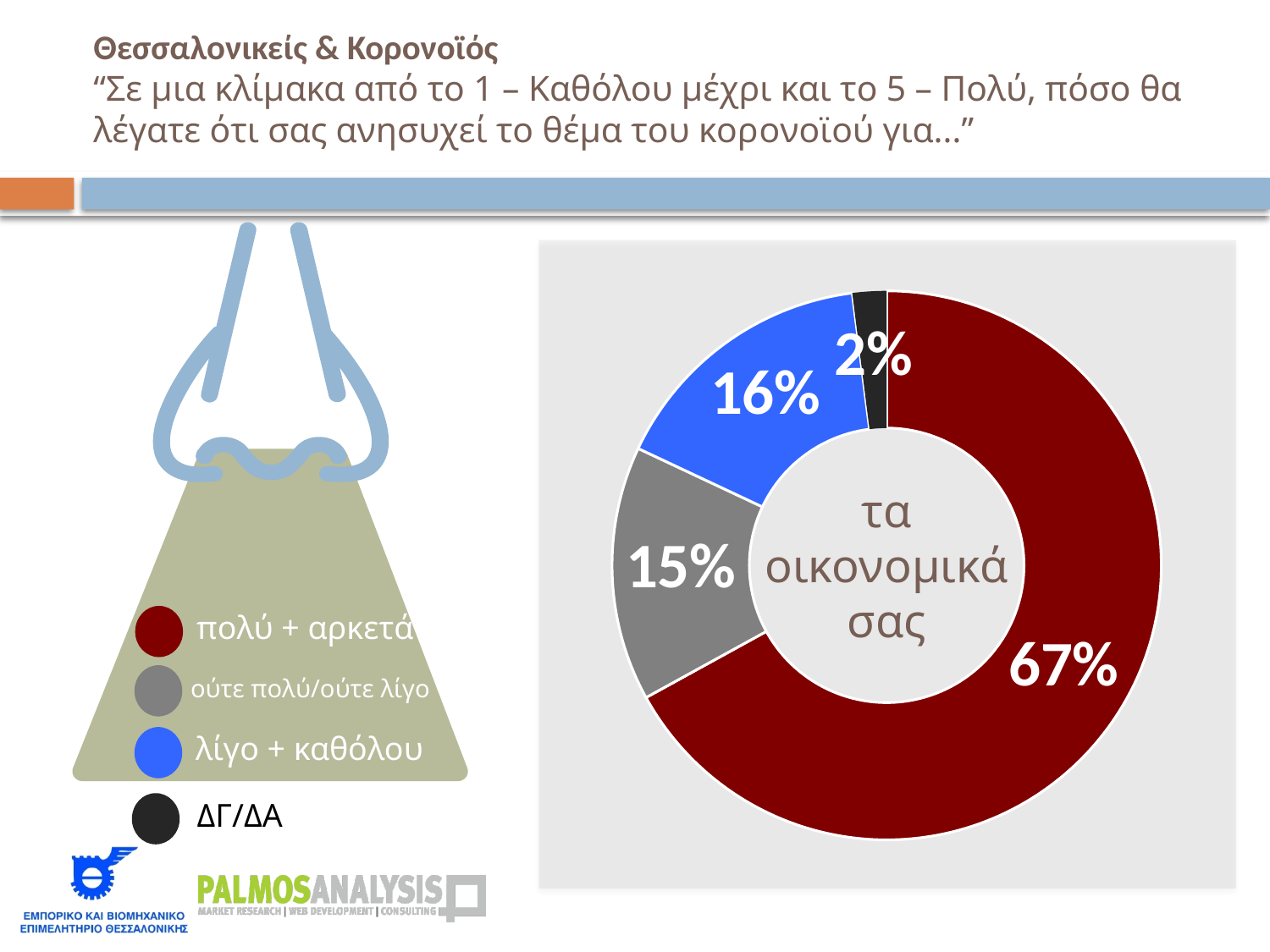
Which response category has the smallest share of the doughnut chart? ΔΓ/ΔΑ What percentage of respondents answered "πολύ + αρκετά" regarding concern about "τα οικονομικά σας"? 67% What percentage of respondents answered "λίγο + καθόλου"? 16% What topic is written in the centre of the doughnut chart? τα οικονομικά σας Which response category has the largest share of the doughnut chart? πολύ + αρκετά How many response categories are shown in the doughnut chart? 4 Which is larger: the share for "λίγο + καθόλου" or the share for "ούτε πολύ/ούτε λίγο"? λίγο + καθόλου What percentage of respondents answered "ούτε πολύ/ούτε λίγο"? 15% What is the difference in percentage points between "πολύ + αρκετά" and "λίγο + καθόλου"? 51 What percentage of respondents answered "ΔΓ/ΔΑ"? 2% What colour represents the "λίγο + καθόλου" category in the chart? Blue What type of chart is shown on the slide? Doughnut chart